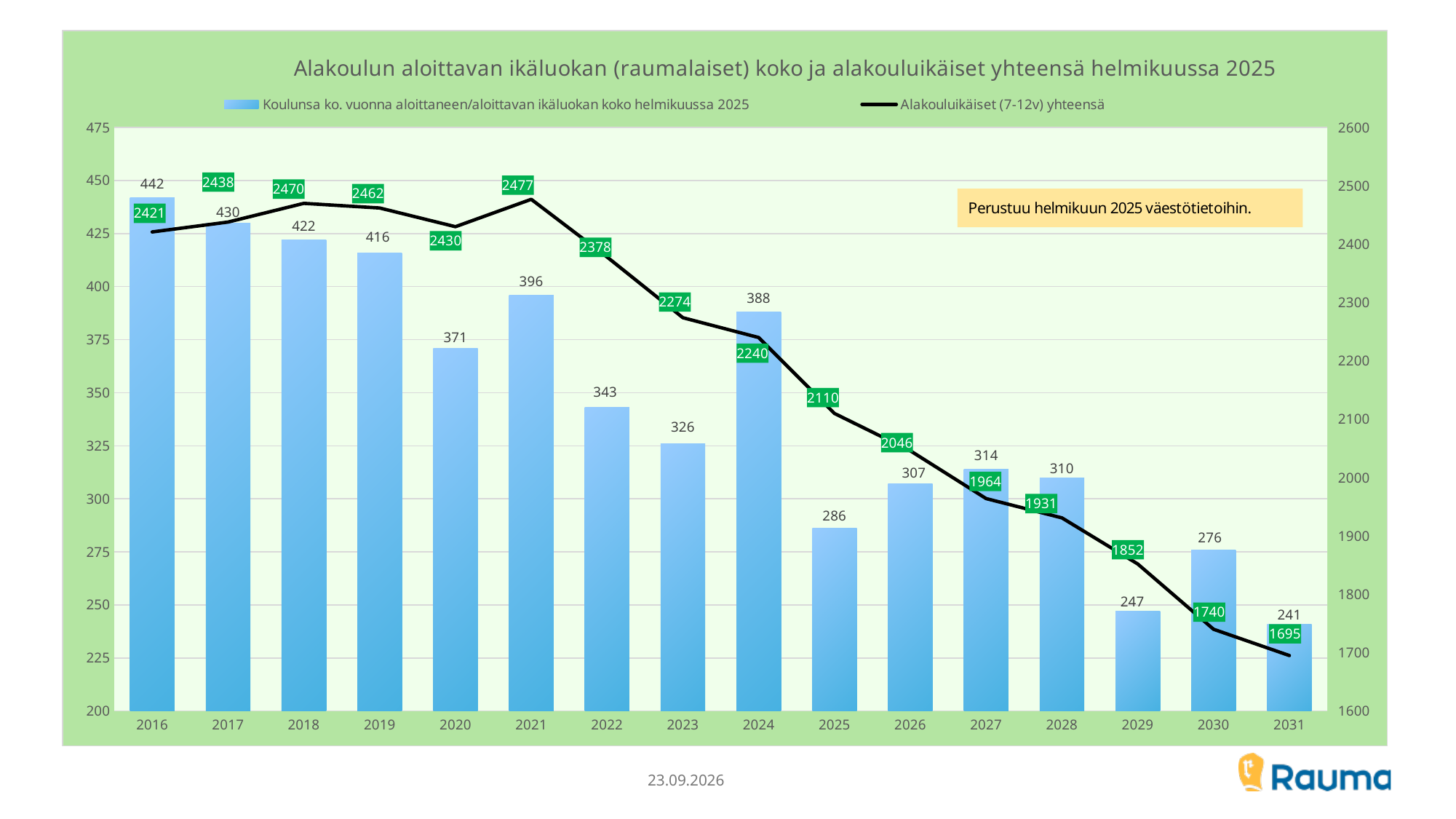
What is the value of the bar for 2016? 442 What is the value of the line series (Alakouluikäiset (7-12v) yhteensä) for 2021? 2477 How many years are shown on the x axis? 16 Which is larger, the bar value for 2027 or the bar value for 2028? 2027 Which year has the highest value on the line series? 2021 Which year has the lowest bar value? 2031 Does the line series generally rise or fall from 2021 to 2031? Fall What kind of chart is shown on the slide? Combined bar and line chart What is the difference between the bar values for 2024 and 2025? 102 How many series does the legend list? 2 What is the difference between the line values for 2030 and 2031? 45 What is the value of the bar for 2025? 286